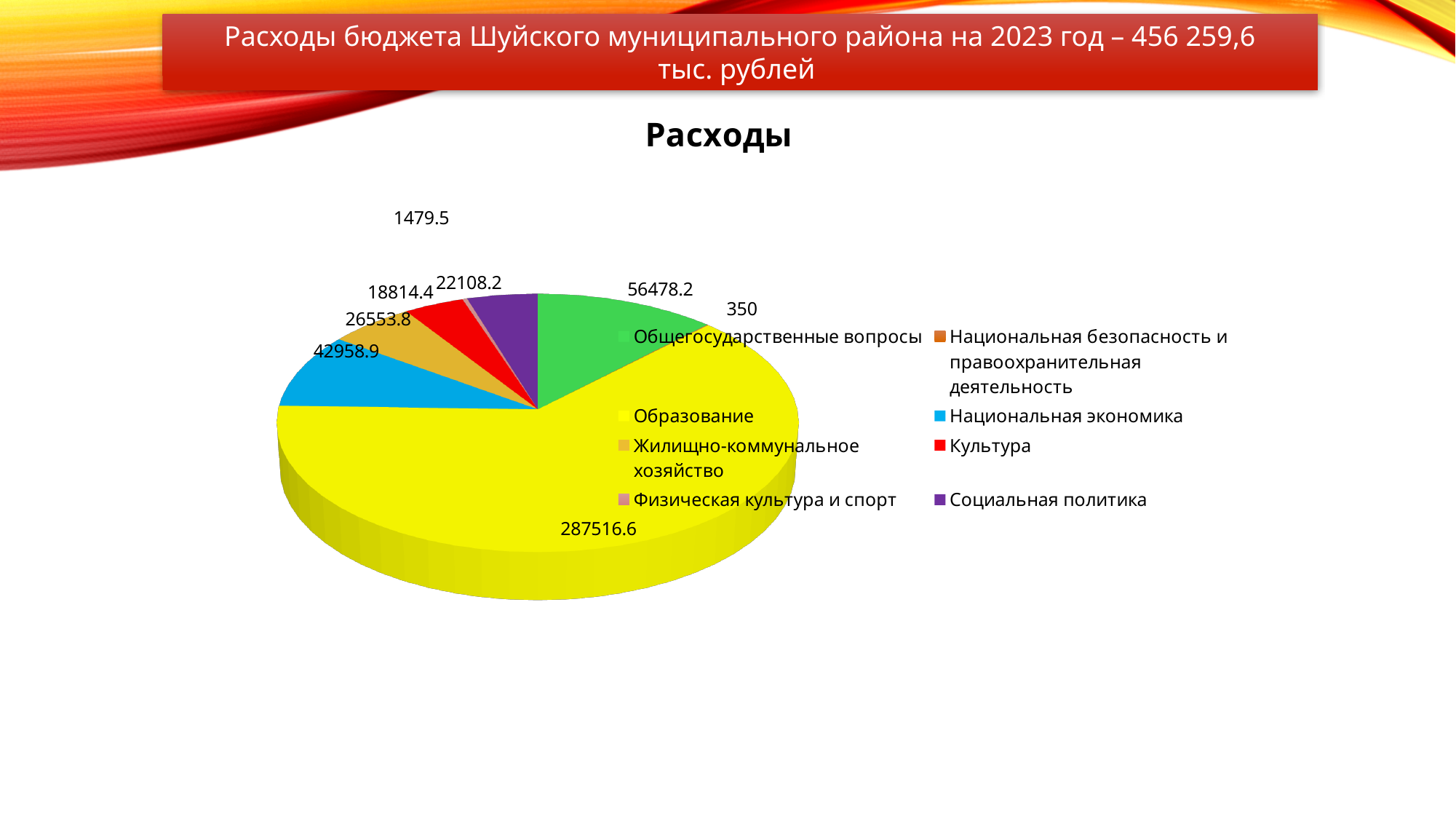
What is the title of the chart? Расходы How many categories does the pie chart have? 8 What is the difference between the values for Общегосударственные вопросы and Национальная экономика? 13519.3 What is the value for Образование? 287516.6 Which category has the smallest value? Национальная безопасность и правоохранительная деятельность What is the value for Национальная экономика? 42958.9 Which category has the largest slice of the pie? Образование What is the value for Социальная политика? 22108.2 What is the value for Культура? 18814.4 Which is larger: Социальная политика or Культура? Социальная политика What type of chart is shown on the slide? pie chart What is the value for Общегосударственные вопросы? 56478.2